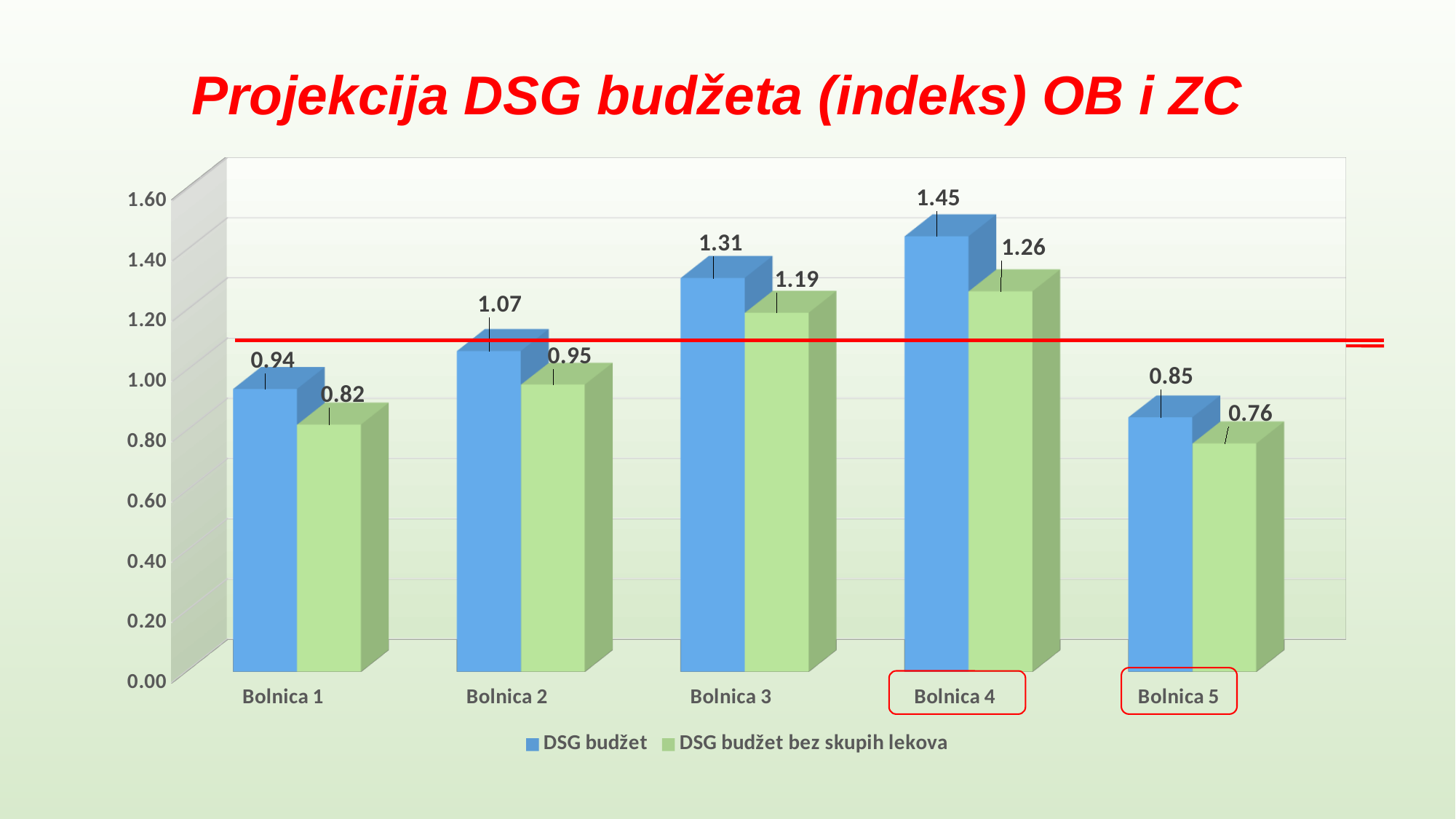
How many categories are shown on the x axis? 5 What is the difference between the DSG budžet and DSG budžet bez skupih lekova values for Bolnica 4? 0.19 Which category has the highest DSG budžet value? Bolnica 4 What is the DSG budžet value for Bolnica 3? 1.31 Which is larger for Bolnica 2: DSG budžet or DSG budžet bez skupih lekova? DSG budžet What is the DSG budžet value for Bolnica 1? 0.94 What kind of chart is shown on the slide? bar chart What is the title of the slide? Projekcija DSG budžeta (indeks) OB i ZC What is the DSG budžet bez skupih lekova value for Bolnica 5? 0.76 Is the DSG budžet value for Bolnica 5 greater or less than 1.00? less How many series does the legend list? 2 Which category has the lowest DSG budžet bez skupih lekova value? Bolnica 5